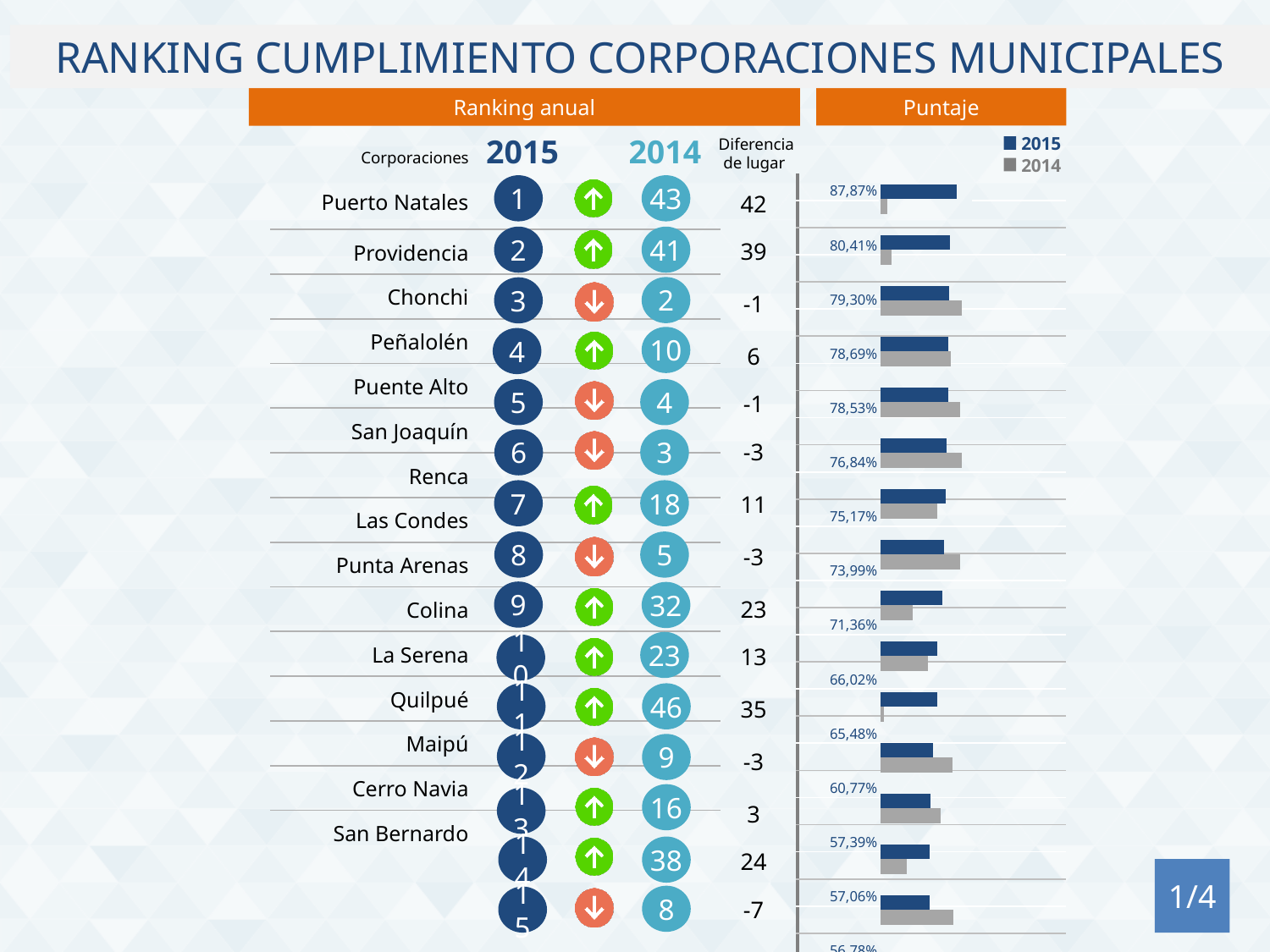
In the 'Puntaje' chart, what is the 2015 score for the second-ranked corporation, Providencia? 80,41% In the 'Puntaje' chart, do the 2015 values rise or fall going from the top bar to the bottom bar? Fall In the 'Puntaje' chart, what is the highest 2015 value shown? 87,87% In the 'Puntaje' chart, which colour represents the 2015 series? Dark blue In the 'Puntaje' chart, for the third bar (Chonchi), which series has the larger value, 2015 or 2014? 2014 What kind of chart is the 'Puntaje' chart on the right of the slide? Bar chart In the 'Puntaje' chart, for the top bar (Puerto Natales), which series has the larger value, 2015 or 2014? 2015 Which two years are listed in the legend of the 'Puntaje' chart? 2015 and 2014 In the 'Puntaje' chart, what is the 2015 score for the top-ranked corporation, Puerto Natales? 87,87% How many series does the legend of the 'Puntaje' chart list? 2 In the 'Puntaje' chart, what is the difference between the 2015 scores of the first-ranked (87,87%) and second-ranked (80,41%) corporations? 7,46 percentage points